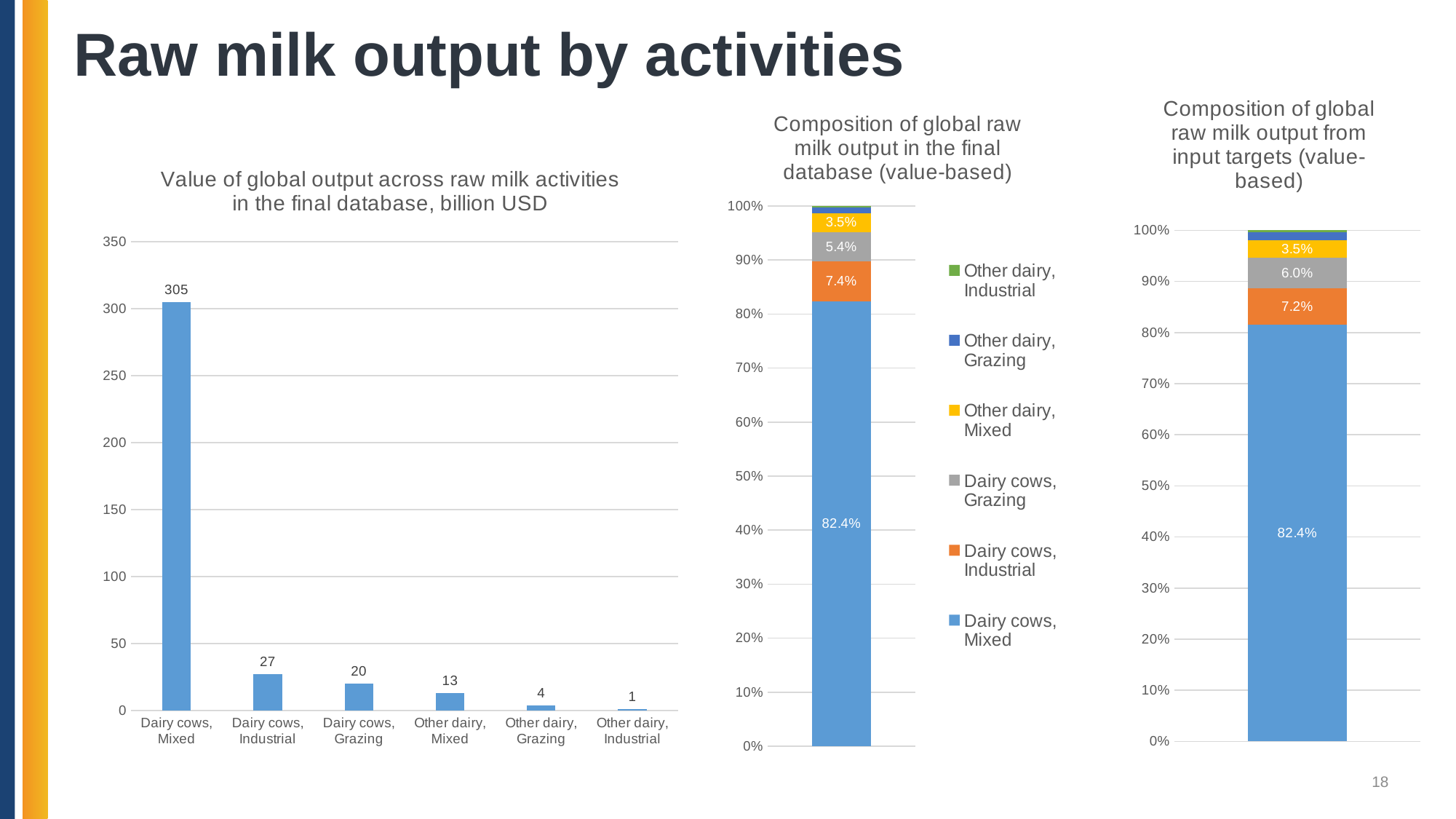
In the chart 'Value of global output across raw milk activities in the final database, billion USD', what is the value for Dairy cows, Grazing? 20 In the chart 'Composition of global raw milk output in the final database (value-based)', what share is labelled for Dairy cows, Industrial? 7.4% In the chart 'Value of global output across raw milk activities in the final database, billion USD', which category has the lowest value? Other dairy, Industrial In the chart 'Value of global output across raw milk activities in the final database, billion USD', which category has the highest value? Dairy cows, Mixed In the chart 'Value of global output across raw milk activities in the final database, billion USD', how many categories are shown on the x axis? 6 In the chart 'Value of global output across raw milk activities in the final database, billion USD', do the values rise or fall from left to right along the x axis? fall What kind of chart is 'Value of global output across raw milk activities in the final database, billion USD'? bar chart In the chart 'Value of global output across raw milk activities in the final database, billion USD', what is the value for Dairy cows, Mixed? 305 In the chart 'Composition of global raw milk output in the final database (value-based)', how many series does the legend list? 6 In the chart 'Value of global output across raw milk activities in the final database, billion USD', what is the difference between Dairy cows, Industrial and Other dairy, Mixed? 14 In the chart 'Composition of global raw milk output from input targets (value-based)', what share is labelled for Dairy cows, Grazing? 6.0% In the chart 'Composition of global raw milk output from input targets (value-based)', which is larger, the share for Dairy cows, Industrial or the share for Other dairy, Mixed? Dairy cows, Industrial